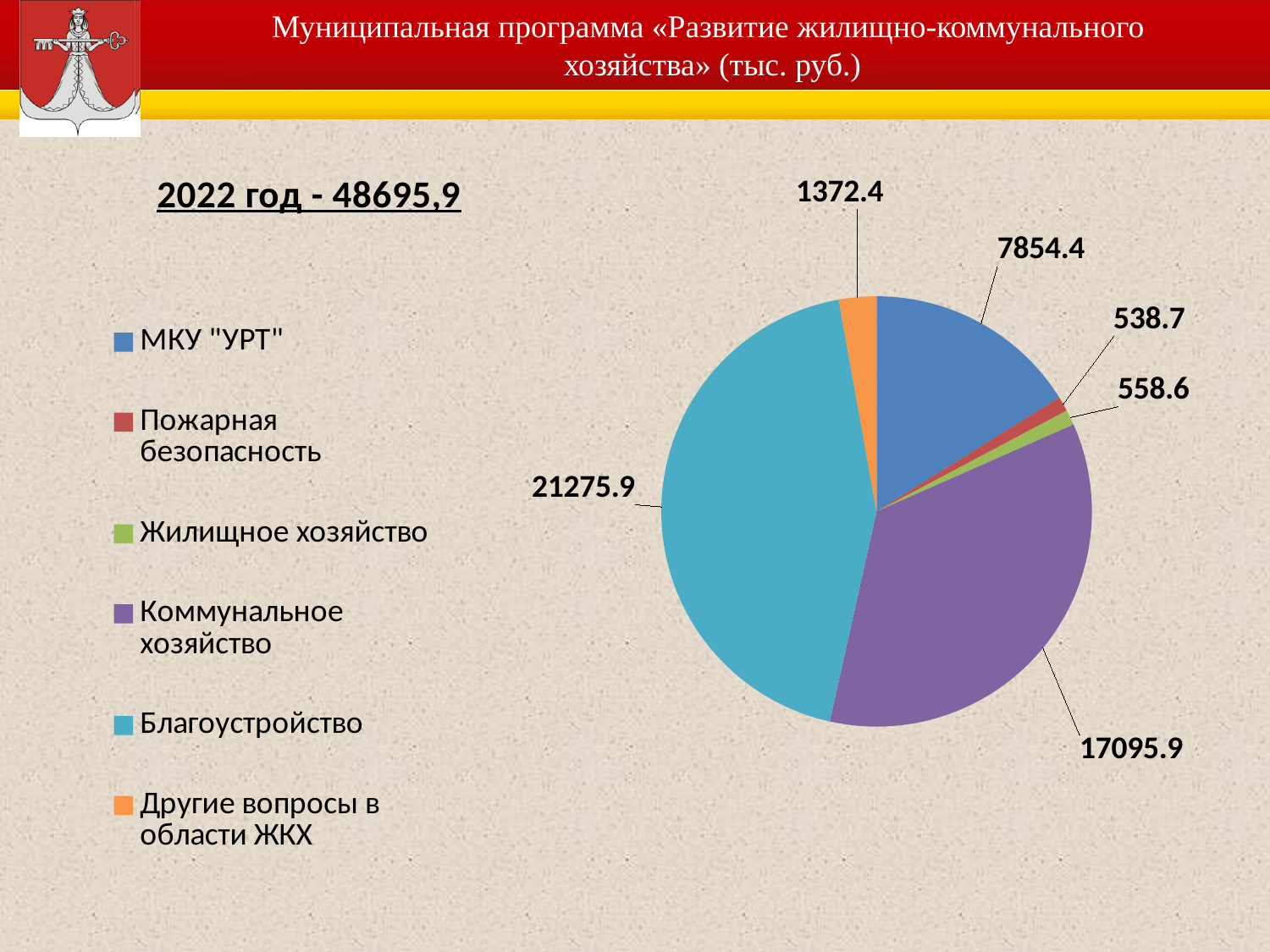
How many categories does the pie chart have? 6 What is the value for Благоустройство? 21275.9 What is the value for Пожарная безопасность? 538.7 Which category has the largest slice of the pie? Благоустройство What is the difference between the values for Благоустройство and Коммунальное хозяйство? 4180.0 What is the value for МКУ "УРТ"? 7854.4 Which is larger, the value for Жилищное хозяйство or the value for Пожарная безопасность? Жилищное хозяйство What total for 2022 is stated on the slide? 48695,9 What is the value for Коммунальное хозяйство? 17095.9 What kind of chart is shown on the slide? Pie chart What is the value for Другие вопросы в области ЖКХ? 1372.4 Which category has the smallest slice of the pie? Пожарная безопасность